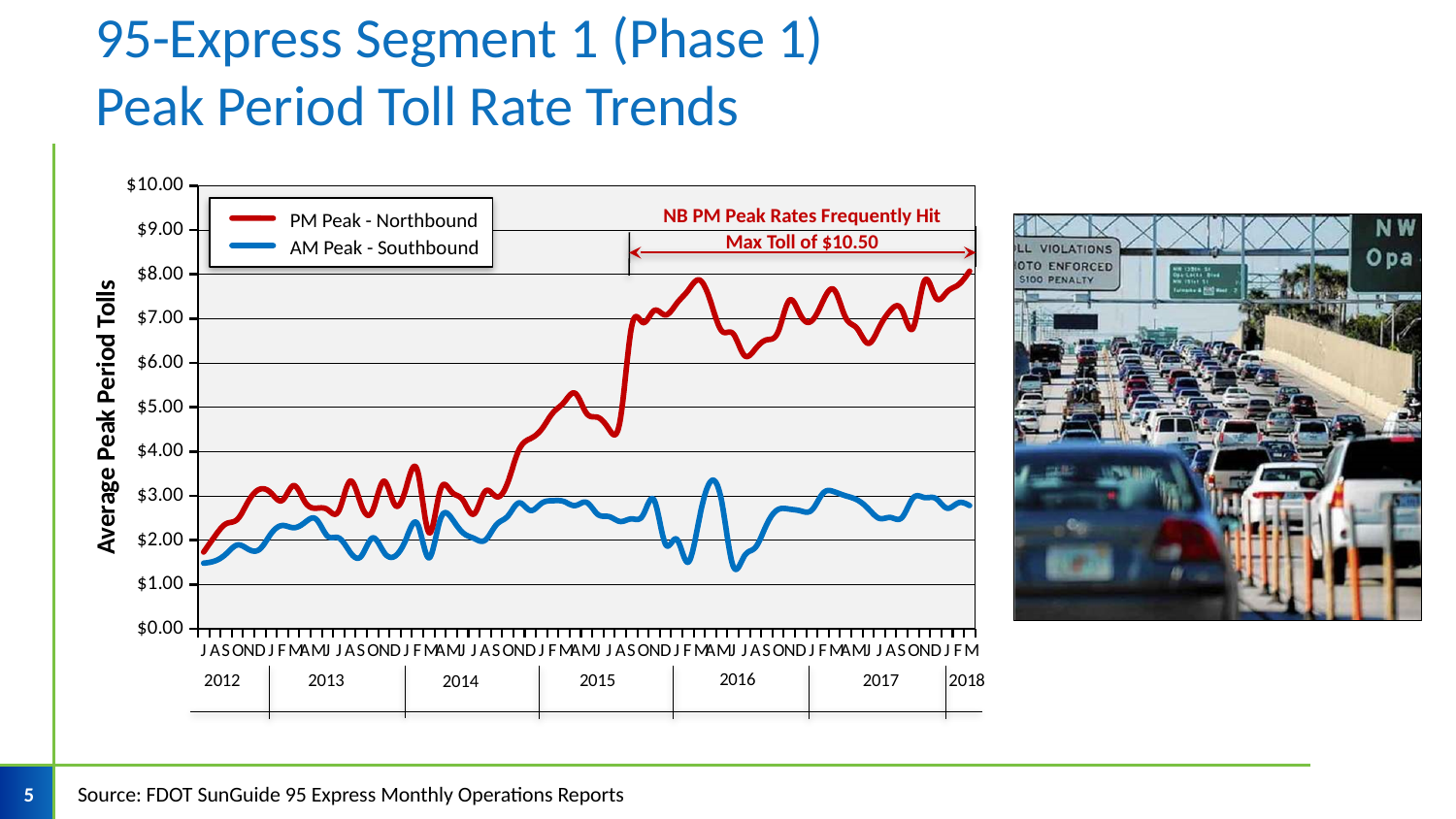
Which series is shown in red in the chart? PM Peak - Northbound What kind of chart is shown on the slide? Line chart Is the value for PM Peak - Northbound in July 2012 greater or less than $3.00? less How many series does the chart legend list? 2 Is the value for AM Peak - Southbound during 2016 greater or less than $5.00? less Which series reaches the highest value on the chart? PM Peak - Northbound Does the PM Peak - Northbound series generally rise or fall from 2012 to 2018? Rise Is the value for AM Peak - Southbound during 2017 greater or less than $4.00? less What is the first year shown on the x axis of the chart? 2012 Which series is higher during 2017, PM Peak - Northbound or AM Peak - Southbound? PM Peak - Northbound What is the label on the vertical axis of the chart? Average Peak Period Tolls